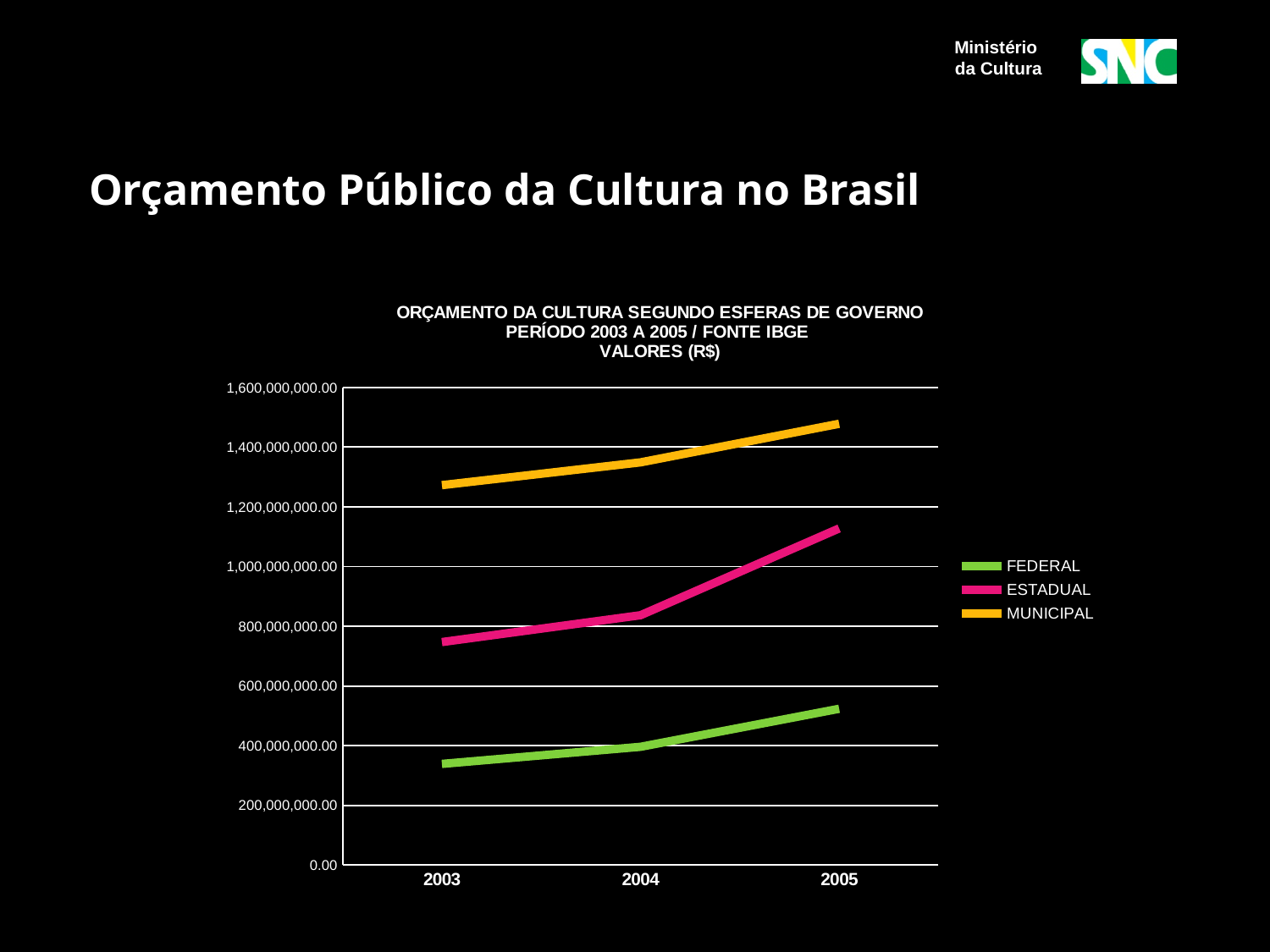
Is the value for ESTADUAL in 2003 greater or less than 800,000,000.00? less Does the ESTADUAL series rise or fall from 2003 to 2005? rise Which series has the highest values across all years? MUNICIPAL Which colour represents the FEDERAL series in the legend? green Which is larger in 2005, the value for MUNICIPAL or the value for ESTADUAL? MUNICIPAL Is the value for FEDERAL in 2003 greater or less than 400,000,000.00? less Which series has the lowest values across all years? FEDERAL How many years are plotted along the x axis? 3 Is the value for ESTADUAL in 2005 greater or less than 1,000,000,000.00? greater How many series does the legend list? 3 What kind of chart is shown on the slide? line chart